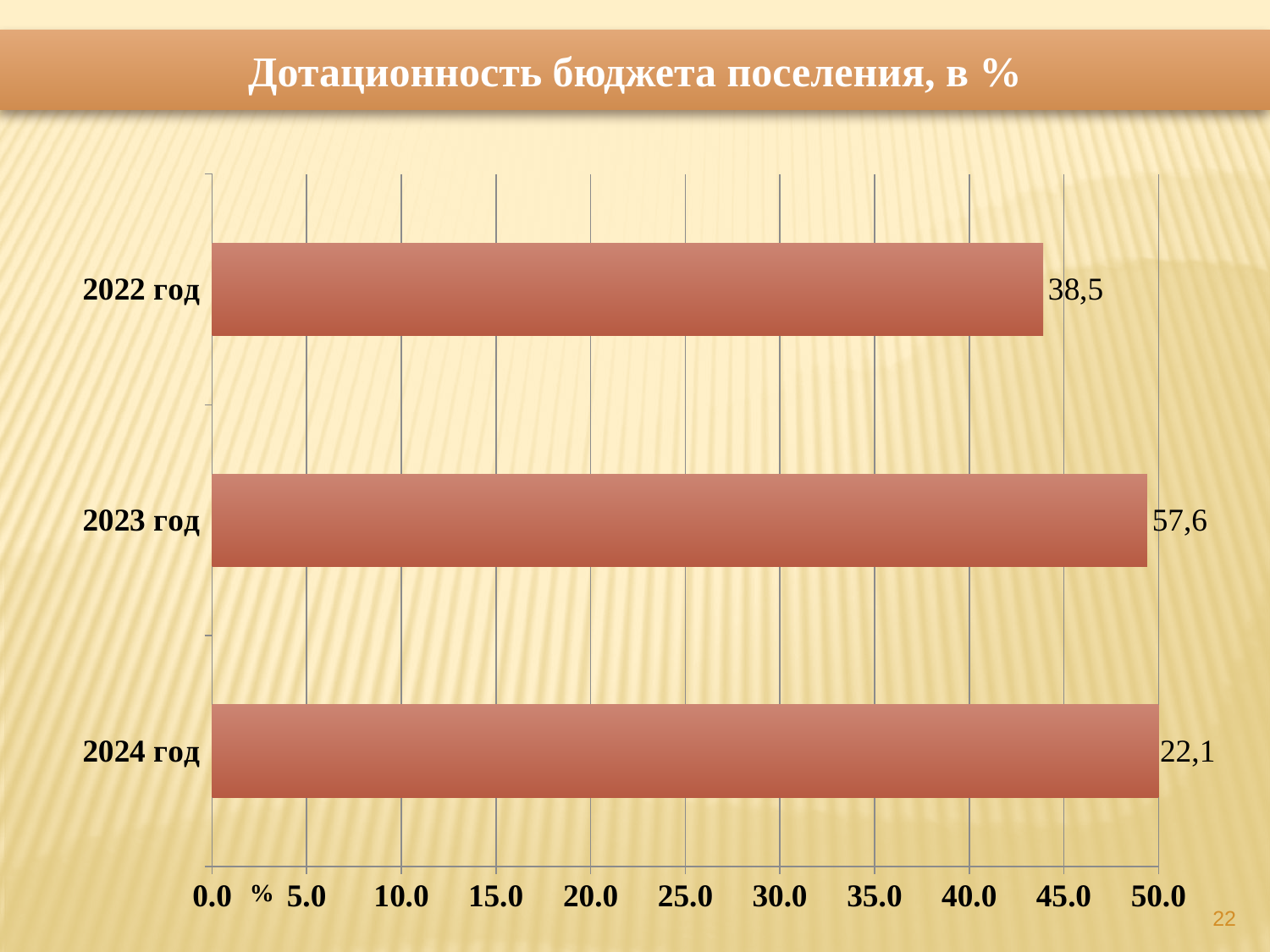
What is the value shown for 2022 год? 38,5 What kind of chart is shown on the slide? Bar chart What is the value shown for 2024 год? 22,1 What is the highest tick value shown on the horizontal axis? 50.0 According to the data labels, what is the difference between the values for 2022 год and 2024 год? 16,4 How many categories (years) are shown on the chart? 3 What is the value shown for 2023 год? 57,6 What is the title of the chart? Дотационность бюджета поселения, в % According to the data labels, what is the difference between the values for 2023 год and 2022 год? 19,1